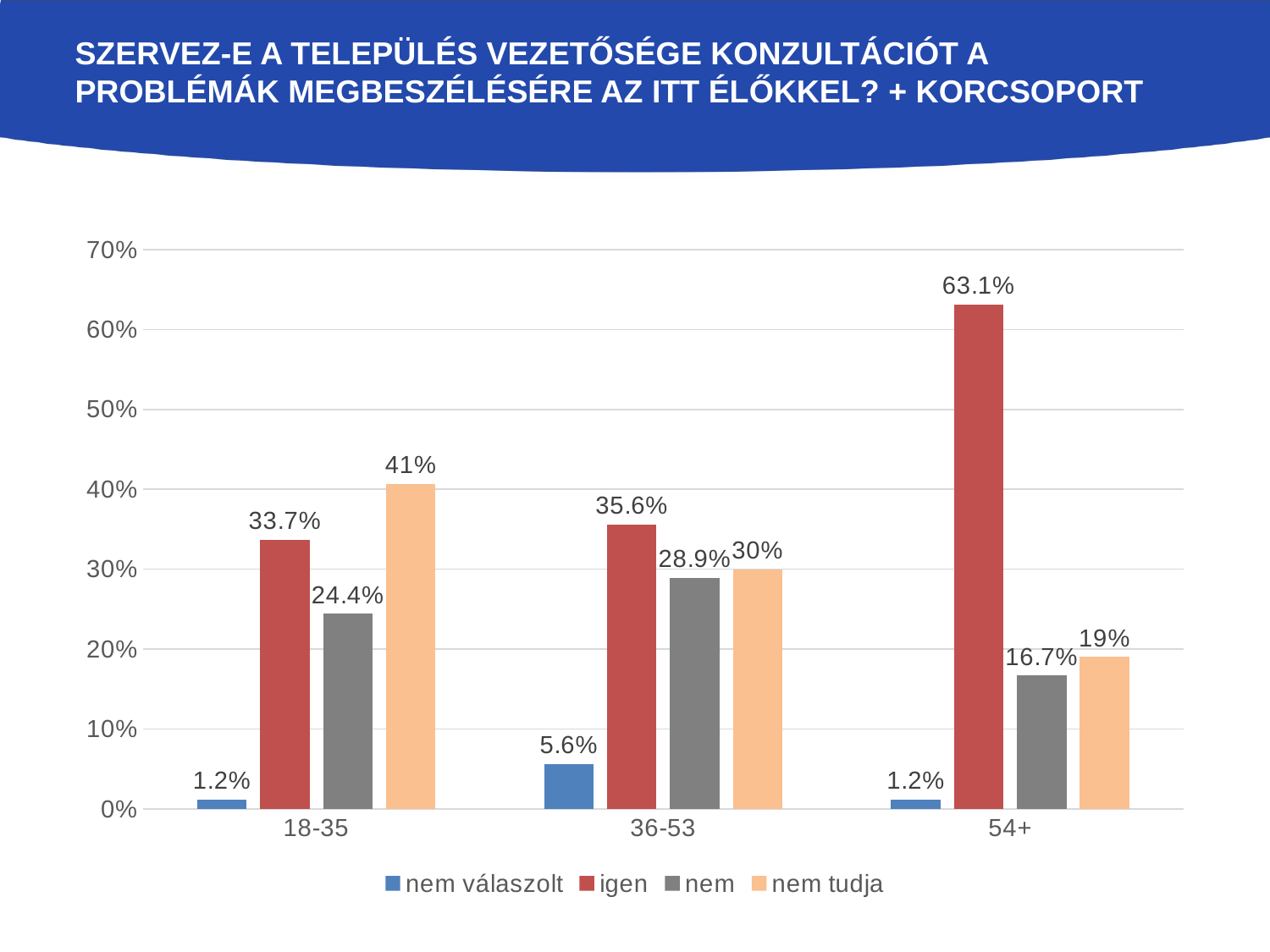
How many series does the legend list? 4 What is the value for "nem" in the 36-53 age group? 28.9% What is the value for "igen" in the 54+ age group? 63.1% What kind of chart is shown on the slide? bar chart What is the difference between the "igen" values for the 54+ and 36-53 age groups? 27.5% What is the value for "nem tudja" in the 18-35 age group? 41% Which age group has the lowest value for "nem"? 54+ Which age group has the highest value for "igen"? 54+ Which is larger in the 18-35 age group: "igen" or "nem tudja"? nem tudja How many age groups are shown on the x axis? 3 What is the value for "nem válaszolt" in the 36-53 age group? 5.6% Which series is shown in red in the legend? igen